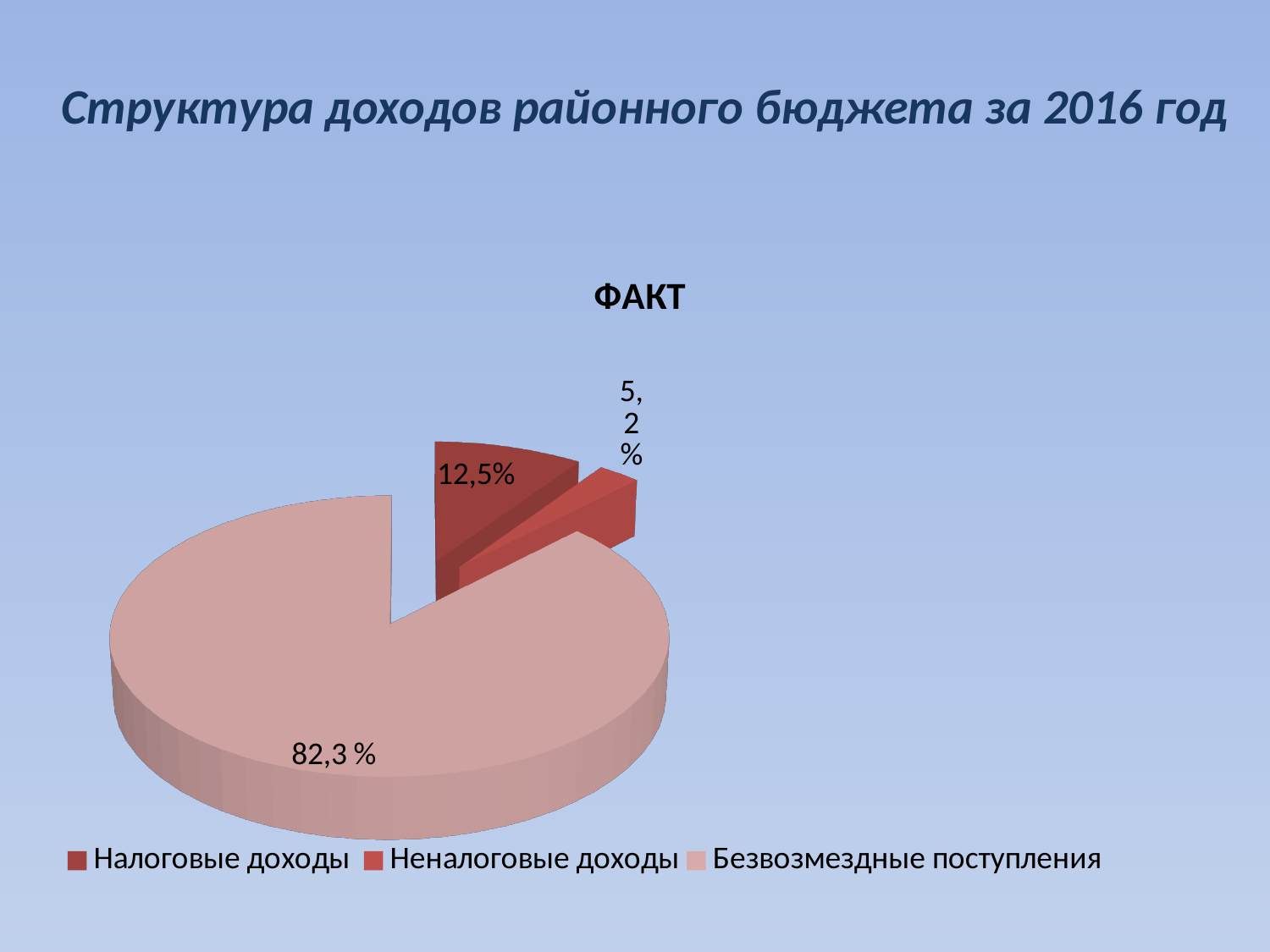
What is the difference in percentage points between Безвозмездные поступления and Налоговые доходы? 69,8 What is the title shown above the pie chart? ФАКТ Which is larger, the slice for Налоговые доходы or the slice for Неналоговые доходы? Налоговые доходы How many slices does the pie chart have? 3 How many entries does the legend list? 3 What share of the pie does Неналоговые доходы represent? 5,2% What share of the pie does Налоговые доходы represent? 12,5% What is the difference in percentage points between Налоговые доходы and Неналоговые доходы? 7,3 Which category has the smallest slice of the pie? Неналоговые доходы Which category has the largest slice of the pie? Безвозмездные поступления What kind of chart is shown on the slide? Pie chart What share of the pie does Безвозмездные поступления represent? 82,3 %